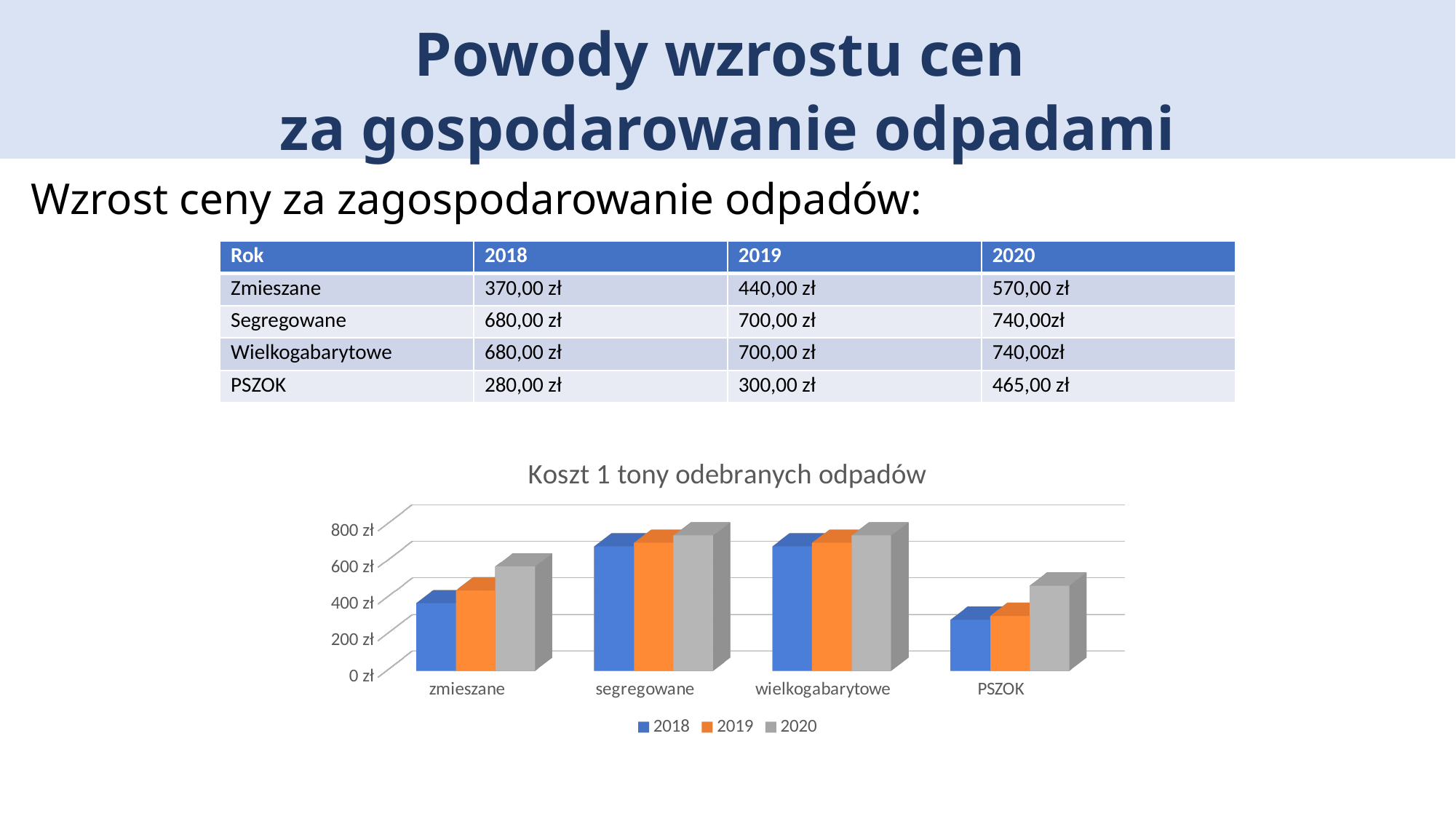
Is the 2020 value for segregowane greater or less than 600 zł? greater Which is larger in the chart: the 2020 value for zmieszane or the 2020 value for PSZOK? zmieszane Is the 2020 value for zmieszane greater or less than 400 zł? greater Which category has the lowest value for 2018 in the chart? PSZOK How many series does the chart legend list? 3 According to the slide, what is the difference between the 2020 and 2018 cost for PSZOK? 185,00 zł According to the slide, what is the 2020 cost for zmieszane? 570,00 zł How many categories are shown on the x axis of the chart? 4 What type of chart is shown on the slide? bar chart What is the title of the chart? Koszt 1 tony odebranych odpadów Is the 2018 value for PSZOK greater or less than 400 zł? less Do the values for PSZOK rise or fall from 2018 to 2020? rise